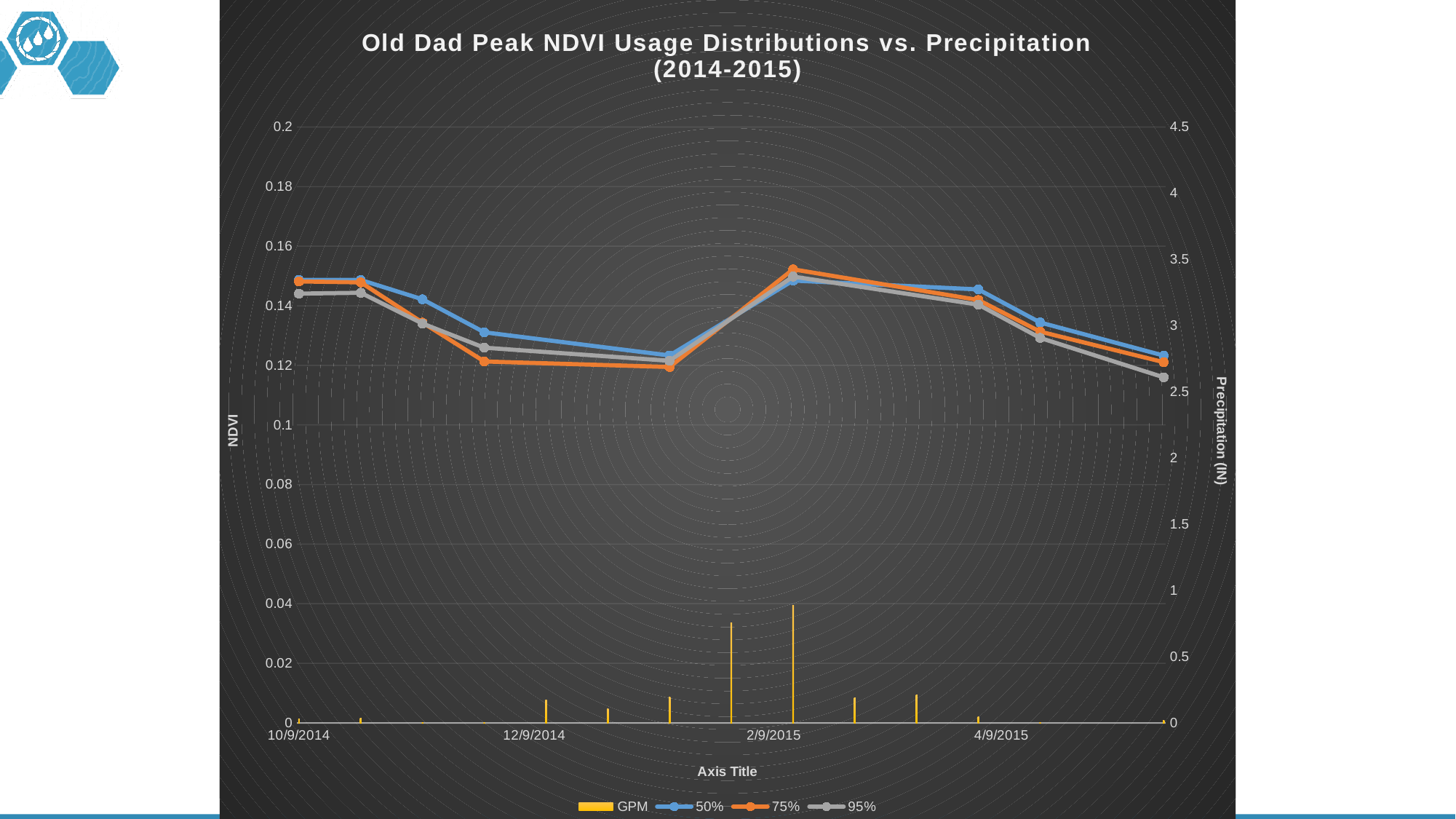
At 10/9/2014, which series has the higher NDVI value, 50% or 95%? 50% Is the tallest GPM precipitation bar greater or less than 0.5 inches? greater Do the 50% NDVI values rise or fall between 10/9/2014 and 12/9/2014? fall What is the title of the chart? Old Dad Peak NDVI Usage Distributions vs. Precipitation (2014-2015) How many series does the legend list? 4 At 12/9/2014, which series has the higher NDVI value, 50% or 75%? 50% Is the 75% NDVI value at 12/9/2014 greater or less than 0.14? less Is the 50% NDVI value at 10/9/2014 greater or less than 0.14? greater What kind of chart is shown on the slide? line chart with bars (combo chart) What is the title of the right-hand vertical axis? Precipitation (IN)